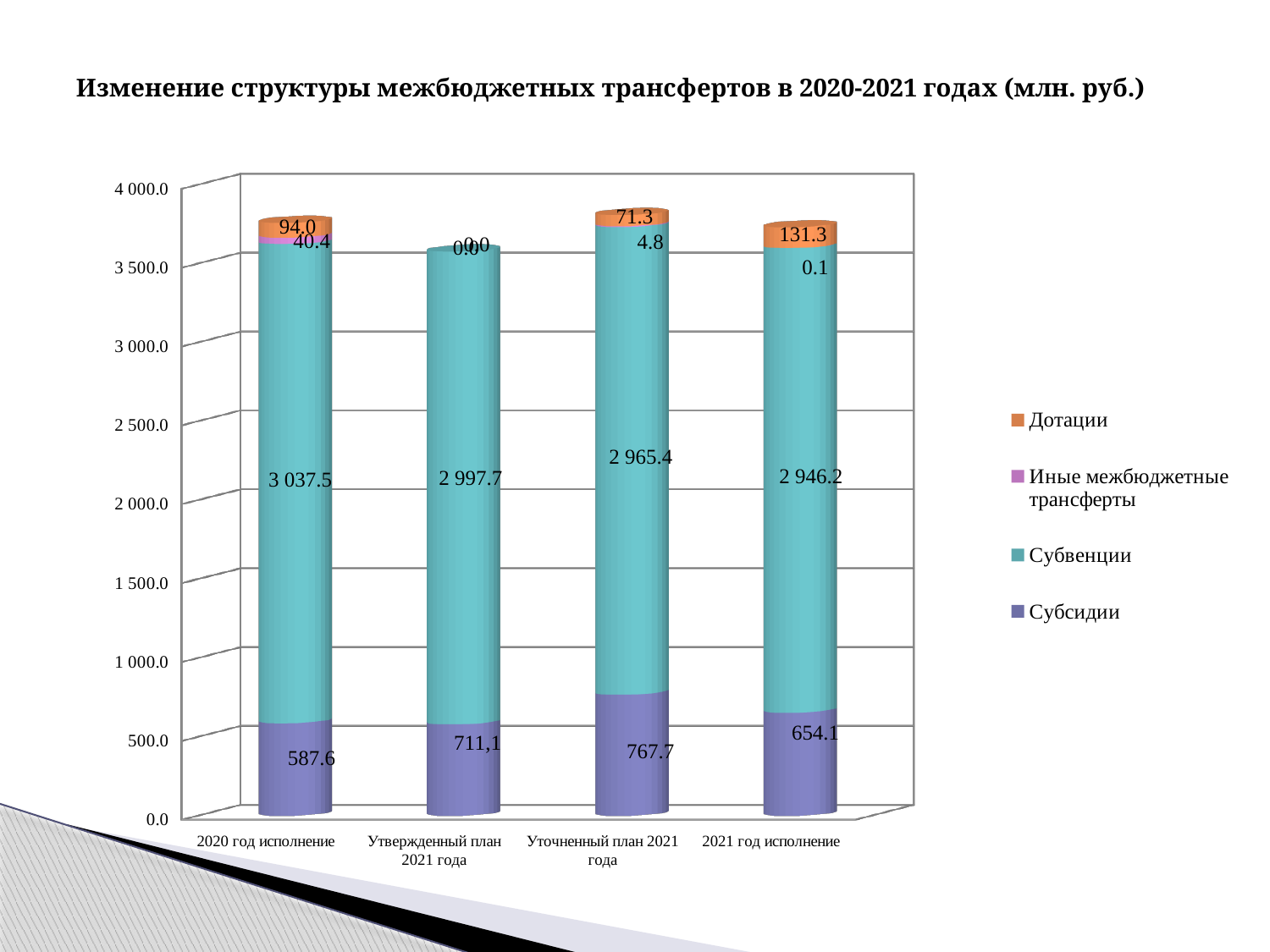
What is the value of Субсидии for Уточненный план 2021 года? 767.7 How many categories are shown on the x axis? 4 What is the value of Иные межбюджетные трансферты for 2020 год исполнение? 40.4 What is the difference between the Субвенции values for 2020 год исполнение and 2021 год исполнение? 91.3 How many series does the legend list? 4 Do the Субвенции values rise or fall from left to right across the categories? fall Which category has the highest value for Субвенции? 2020 год исполнение Is the total height of the bar for 2020 год исполнение greater or less than 3 500.0? greater Which is larger: Субсидии for Уточненный план 2021 года or Субсидии for 2021 год исполнение? Уточненный план 2021 года What is the value of Дотации for 2021 год исполнение? 131.3 What is the value of Субвенции for 2020 год исполнение? 3 037.5